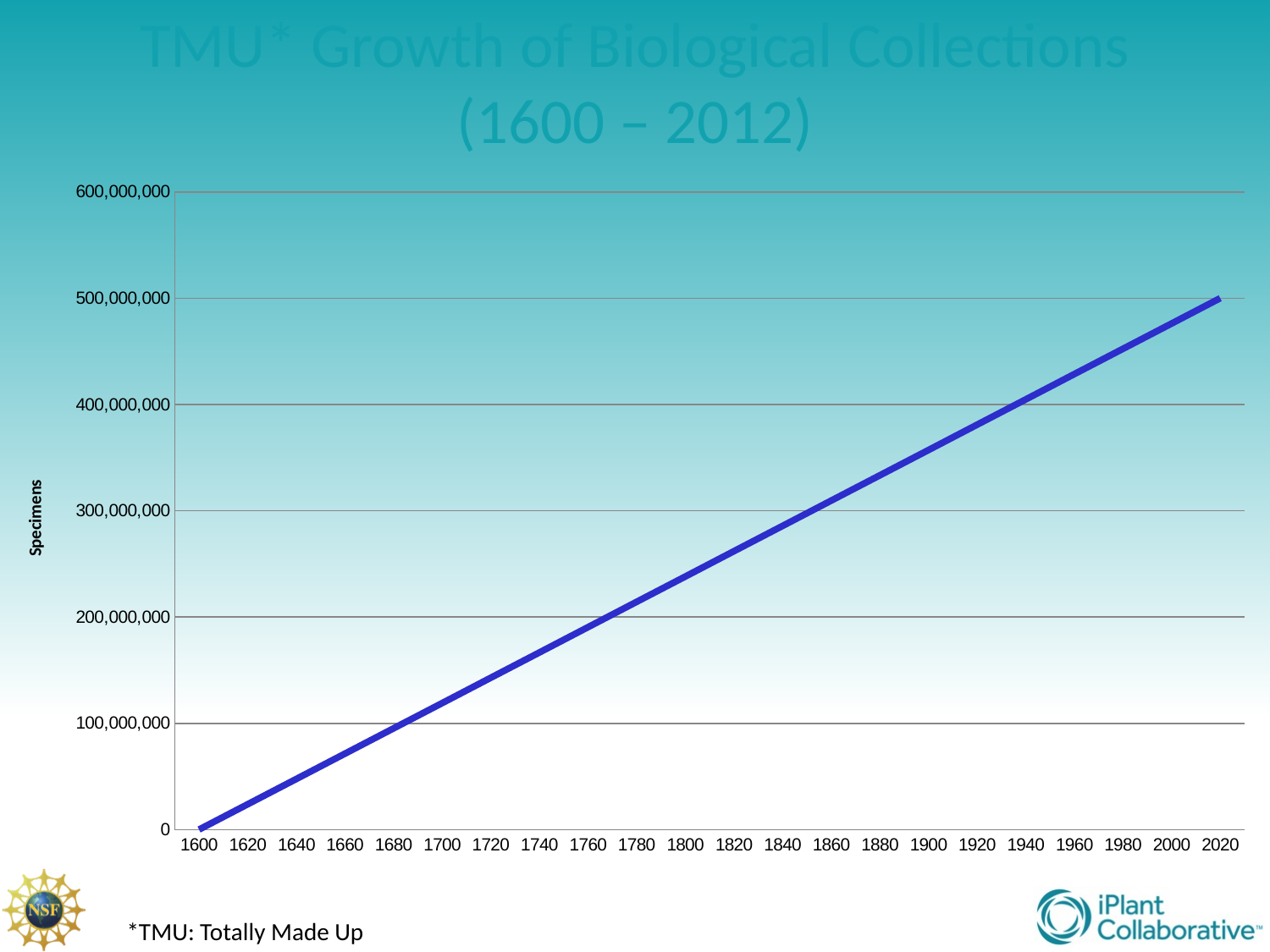
What kind of chart is shown on the slide? line chart Is the value for 1700 greater or less than 100,000,000? greater What is the title of the chart on the slide? TMU* Growth of Biological Collections (1600 – 2012) Is the value for 1640 greater or less than 100,000,000? less What is the label on the vertical axis of the chart? Specimens At which year on the x axis does the line have its lowest value? 1600 Is the value for 2000 greater or less than 500,000,000? less Do the values rise or fall as the years increase along the x axis? rise At which year on the x axis does the line reach its highest value? 2020